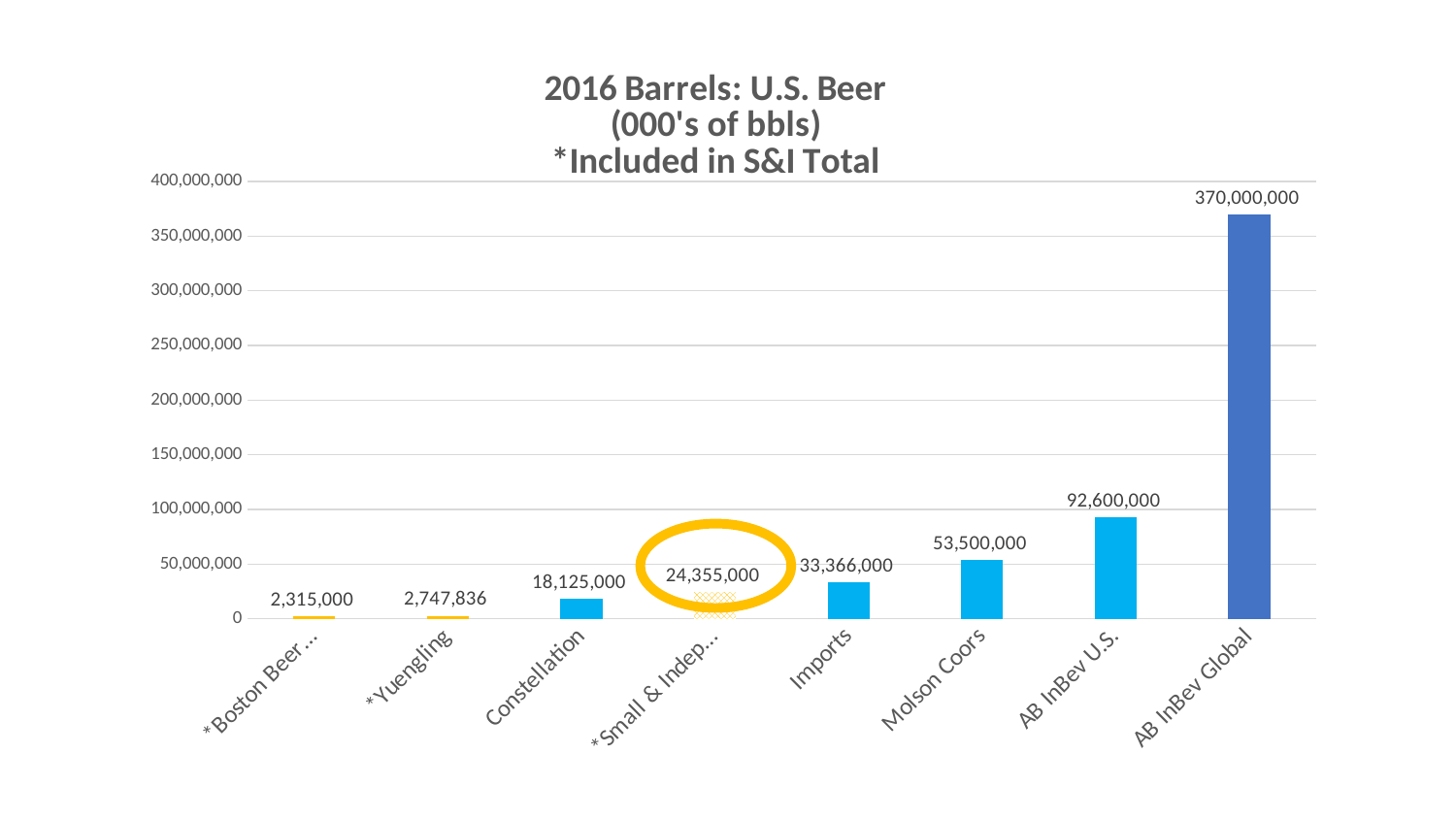
Is the value for AB InBev U.S. greater or less than 100,000,000? less What is the value shown for Imports? 33,366,000 What is the value shown for AB InBev Global? 370,000,000 What is the value shown for *Yuengling? 2,747,836 What is the difference between the values for AB InBev Global and AB InBev U.S.? 277,400,000 What value is labelled on the bar circled in yellow? 24,355,000 Which is larger, the value for Molson Coors or the value for Imports? Molson Coors Which category has the lowest value? *Boston Beer What is the value shown for Molson Coors? 53,500,000 How many categories are shown on the x axis? 8 What is the value shown for Constellation? 18,125,000 Which category has the highest value? AB InBev Global